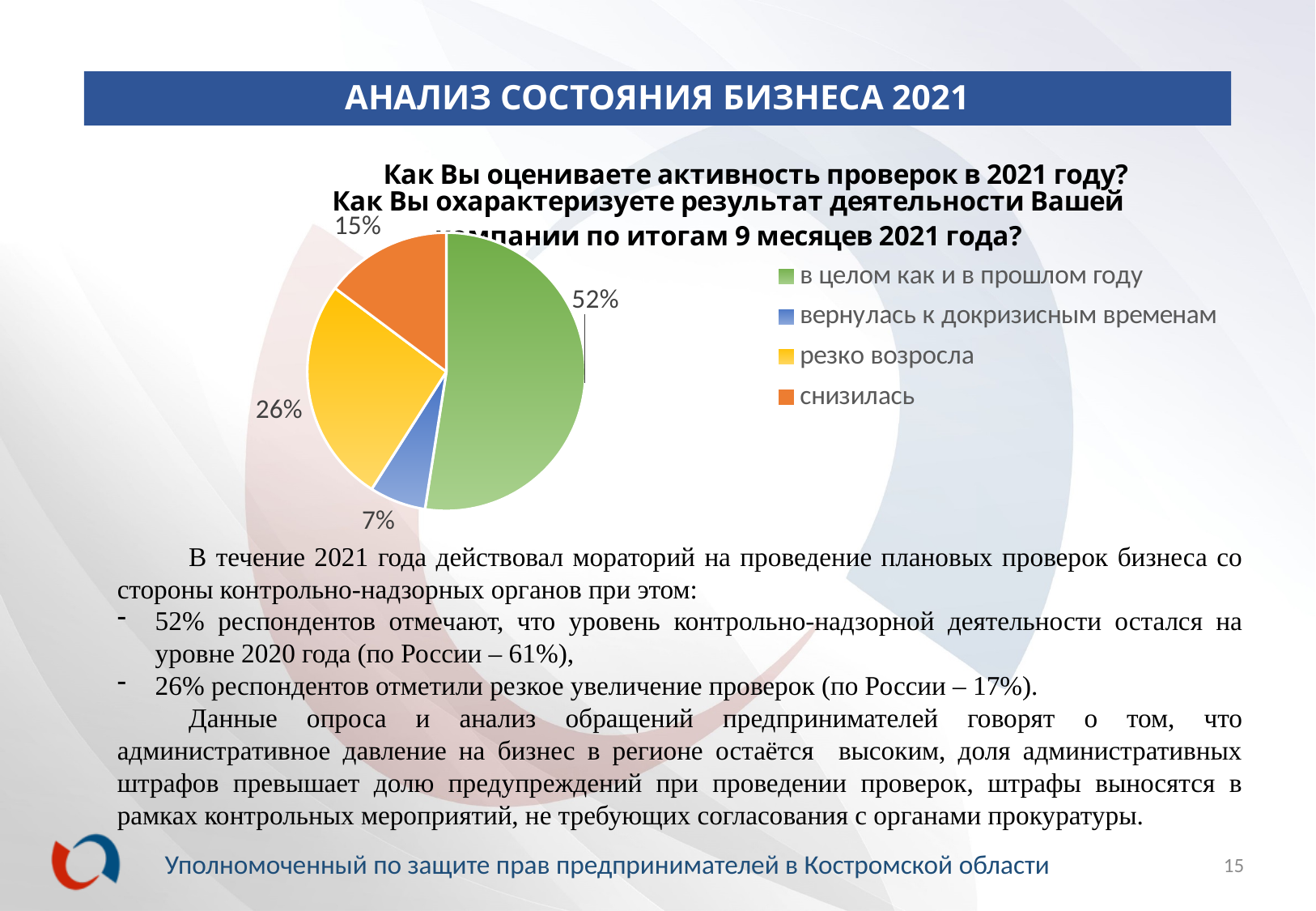
Which answer option has the smallest slice of the pie? вернулась к докризисным временам What share of respondents answered "резко возросла"? 26% What is the difference in percentage points between "в целом как и в прошлом году" and "резко возросла"? 26 What share of respondents answered "вернулась к докризисным временам"? 7% What share of respondents answered "снизилась"? 15% What is the difference in percentage points between "снизилась" and "вернулась к докризисным временам"? 8 Which answer option has the largest slice of the pie? в целом как и в прошлом году What colour is the slice for "резко возросла"? yellow How many slices does the pie chart have? 4 Which is larger: the share for "резко возросла" or the share for "снизилась"? резко возросла What type of chart is shown on the slide? pie chart What share of respondents answered "в целом как и в прошлом году"? 52%